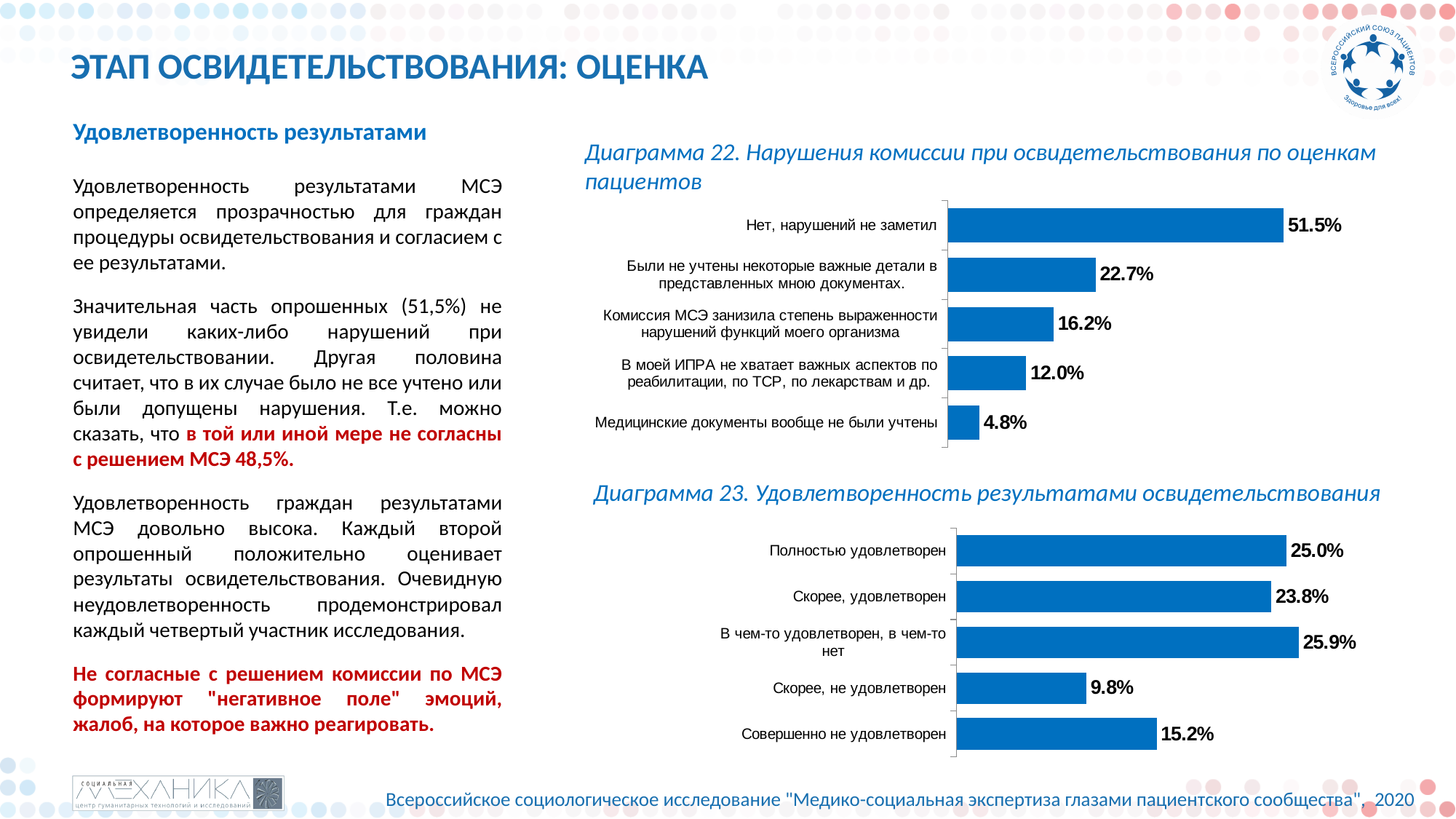
In Диаграмма 22, what is the difference between "Были не учтены некоторые важные детали в представленных мною документах" and "Комиссия МСЭ занизила степень выраженности нарушений функций моего организма"? 6.5% In Диаграмма 23, what is the difference between "Полностью удовлетворен" and "Скорее, не удовлетворен"? 15.2% In Диаграмма 23, which category has the lowest value? Скорее, не удовлетворен In Диаграмма 23, which is larger: "Совершенно не удовлетворен" or "Скорее, не удовлетворен"? Совершенно не удовлетворен In Диаграмма 22, what is the value for "Медицинские документы вообще не были учтены"? 4.8% In Диаграмма 22, which category has the lowest value? Медицинские документы вообще не были учтены In Диаграмма 22, how many categories are shown? 5 In Диаграмма 23, what is the value for "Совершенно не удовлетворен"? 15.2% In Диаграмма 23, which category has the highest value? В чем-то удовлетворен, в чем-то нет What type of chart is Диаграмма 22? Bar chart In Диаграмма 22, what percentage of respondents chose "Нет, нарушений не заметил"? 51.5% In Диаграмма 23, what is the value for "Скорее, удовлетворен"? 23.8%